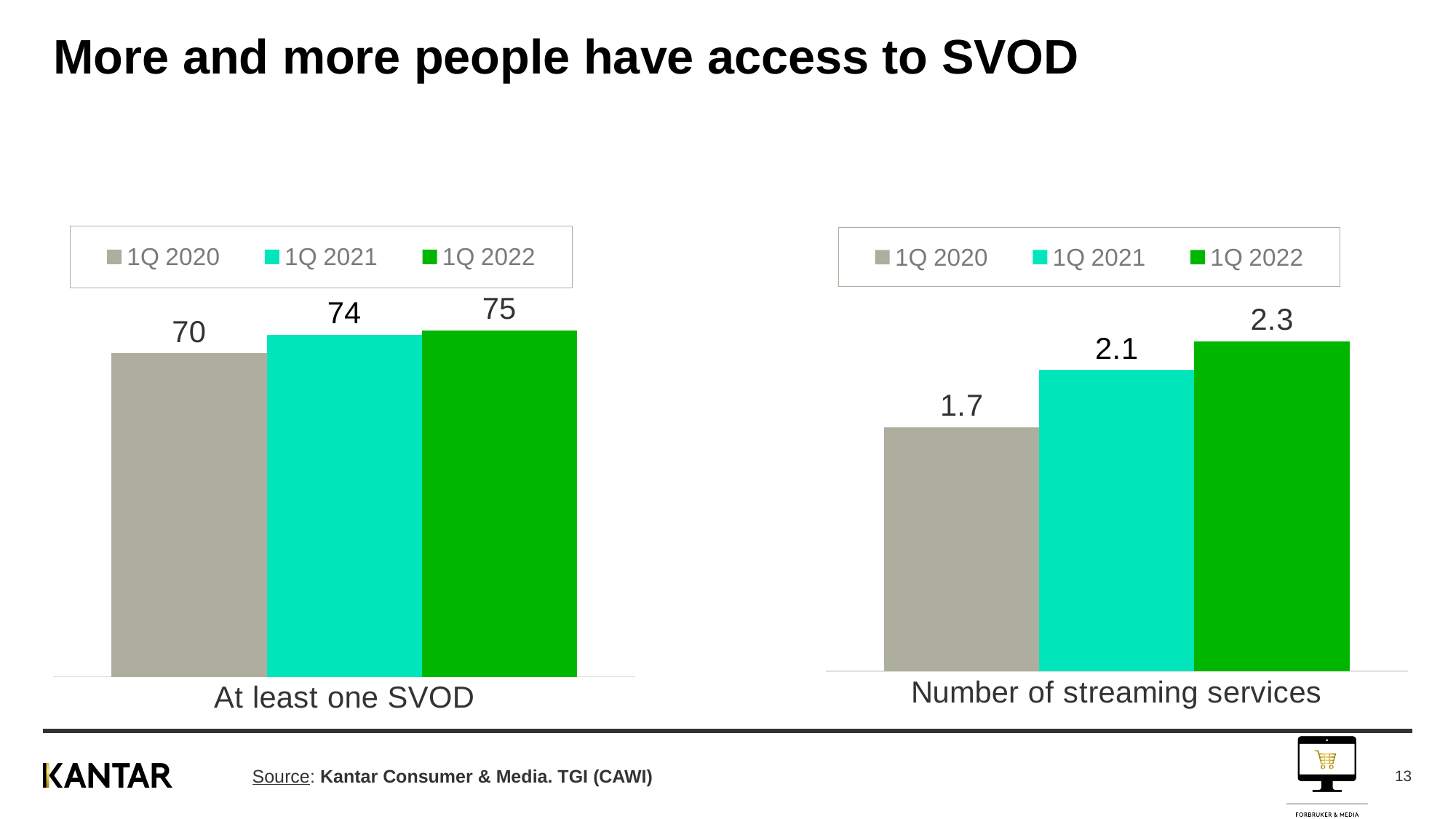
In the right chart (Number of streaming services), which series has the lowest value? 1Q 2020 In the right chart (Number of streaming services), what is the value for 1Q 2022? 2.3 In the left chart (At least one SVOD), what is the difference between the 1Q 2022 and 1Q 2020 values? 5 In the right chart (Number of streaming services), do the values rise or fall from 1Q 2020 to 1Q 2022? Rise In the left chart (At least one SVOD), which is larger: the value for 1Q 2021 or 1Q 2020? 1Q 2021 In the right chart (Number of streaming services), what is the difference between the 1Q 2022 and 1Q 2020 values? 0.6 In the left chart (At least one SVOD), which series has the highest value? 1Q 2022 How many series does the legend of the right chart (Number of streaming services) list? 3 In the right chart (Number of streaming services), what is the value for 1Q 2021? 2.1 In the left chart (At least one SVOD), what is the value for 1Q 2022? 75 In the left chart (At least one SVOD), what is the value for 1Q 2020? 70 What kind of chart is the left chart (At least one SVOD)? Bar chart